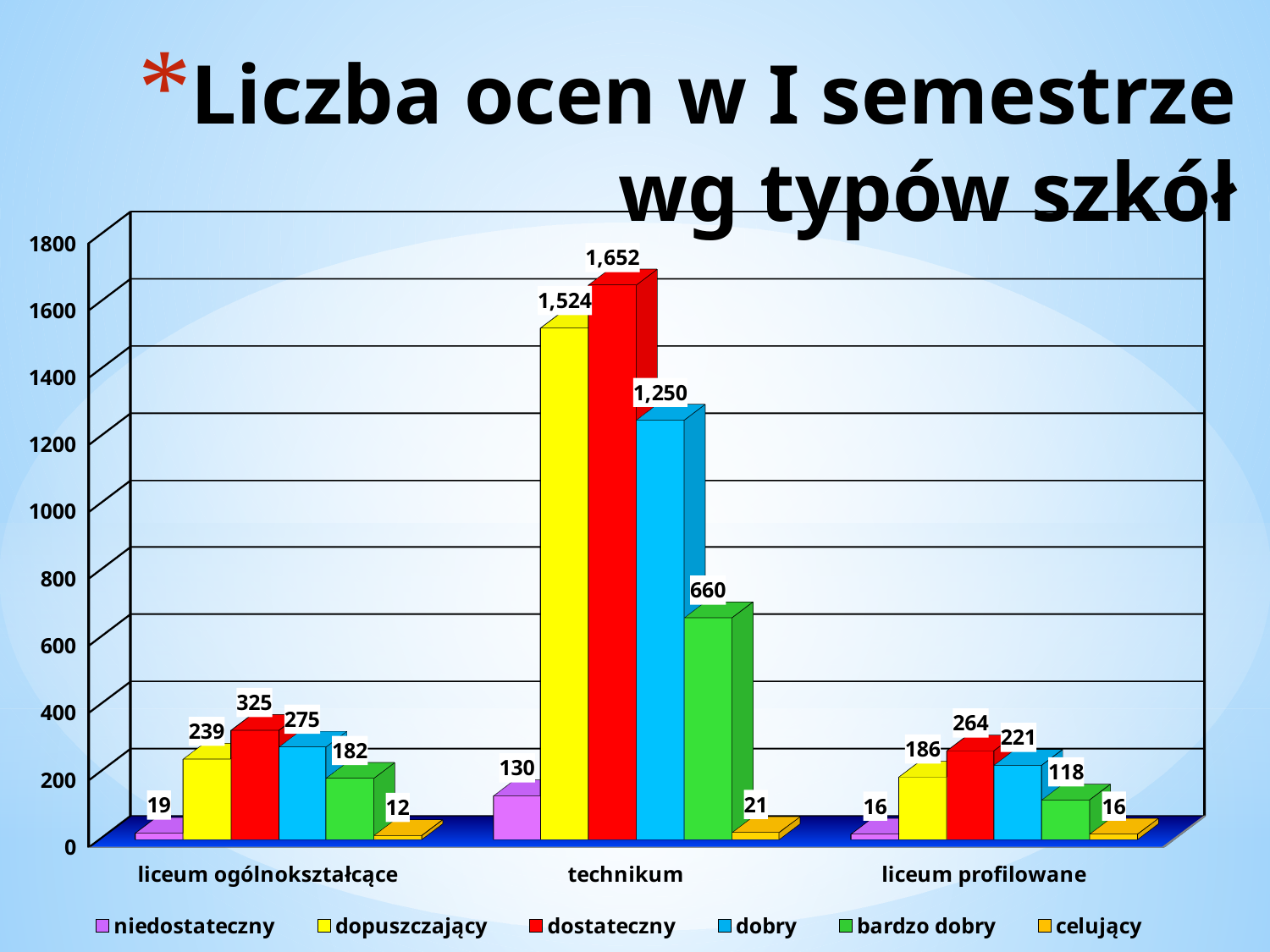
Which is larger in liceum profilowane: dostateczny or dobry? dostateczny What kind of chart is shown on the slide? bar chart What is the value for bardzo dobry in liceum ogólnokształcące? 182 What is the value for celujący in technikum? 21 How many series does the legend list? 6 What is the difference between dostateczny and dopuszczający in technikum? 128 What is the value for dostateczny in technikum? 1,652 Which grade has the lowest value in liceum ogólnokształcące? celujący Which school type has the highest value for dopuszczający? technikum How many school types are shown on the x axis? 3 Is the value for dobry in technikum greater or less than 1200? greater What is the value for dobry in liceum profilowane? 221